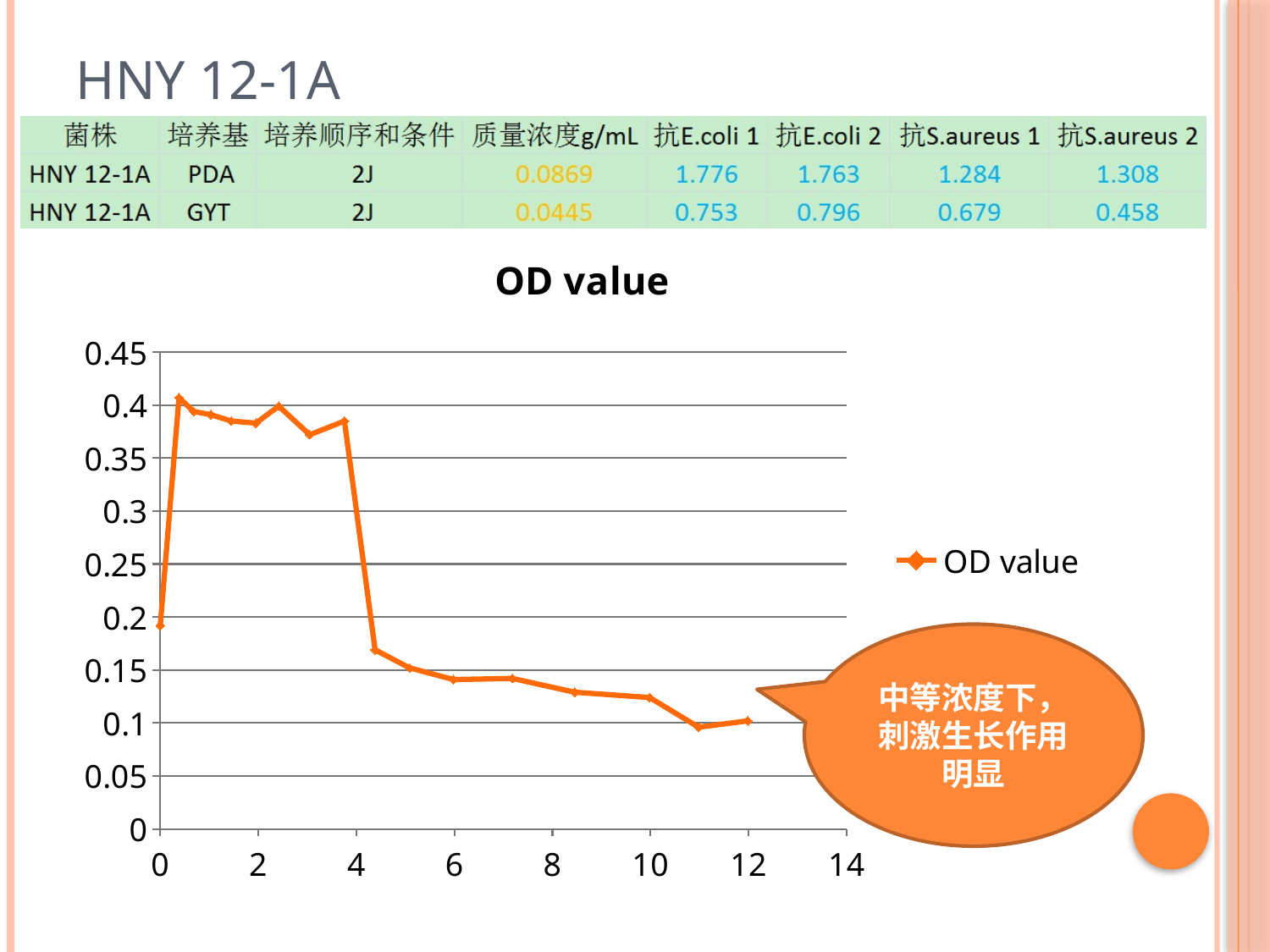
What is the highest value shown on the y axis of the chart? 0.45 How many series does the chart legend list? 1 Is the OD value at x = 2 greater or less than 0.35? greater Between x = 4 and x = 12, does the OD value generally rise or fall? fall Which is larger, the OD value at x = 0 or at x = 6? x = 0 What is the title of the chart? OD value Is the OD value at x = 0 greater or less than 0.15? greater Which is larger, the OD value at x = 2 or at x = 10? x = 2 What is the name of the series shown in the chart legend? OD value Is the OD value at x = 8 greater or less than 0.2? less What kind of chart is shown on the slide? line chart